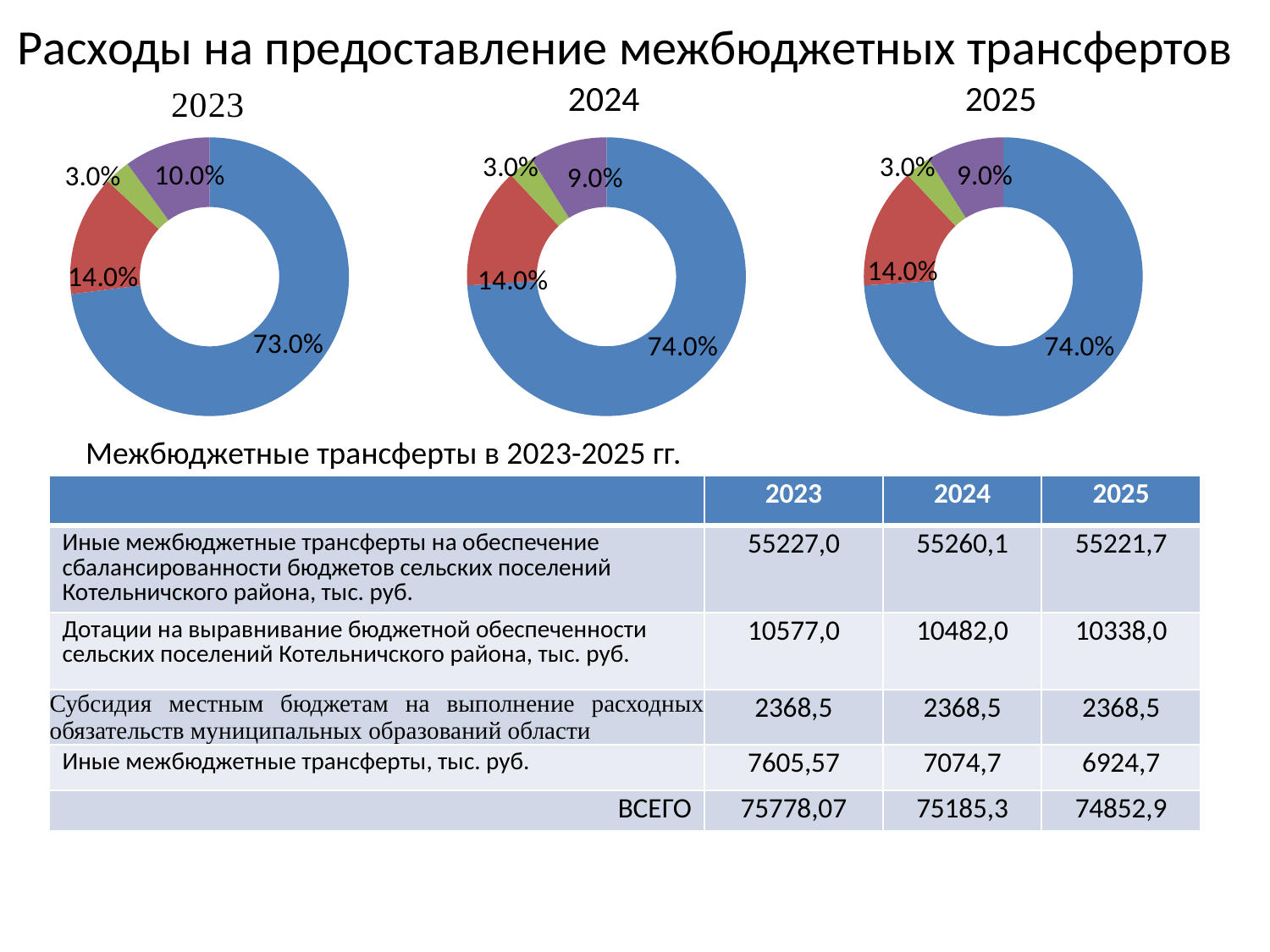
What kind of chart is the 2023 chart? doughnut chart In the 2025 chart, what is the share of the red slice? 14.0% In the 2023 chart, what is the share of the largest slice? 73.0% In the 2025 chart, what is the share of the smallest slice? 3.0% In the 2025 chart, what is the difference between the purple slice and the green slice? 6.0% In the 2023 chart, what is the share of the purple slice? 10.0% In the 2024 chart, what is the share of the purple slice? 9.0% Which is larger: the purple slice in the 2023 chart or the purple slice in the 2024 chart? 2023 How many slices does the 2024 chart have? 4 In the 2024 chart, what is the share of the largest slice? 74.0% How many doughnut charts are shown on the slide? 3 In the 2023 chart, what is the difference between the largest slice and the red slice? 59.0%